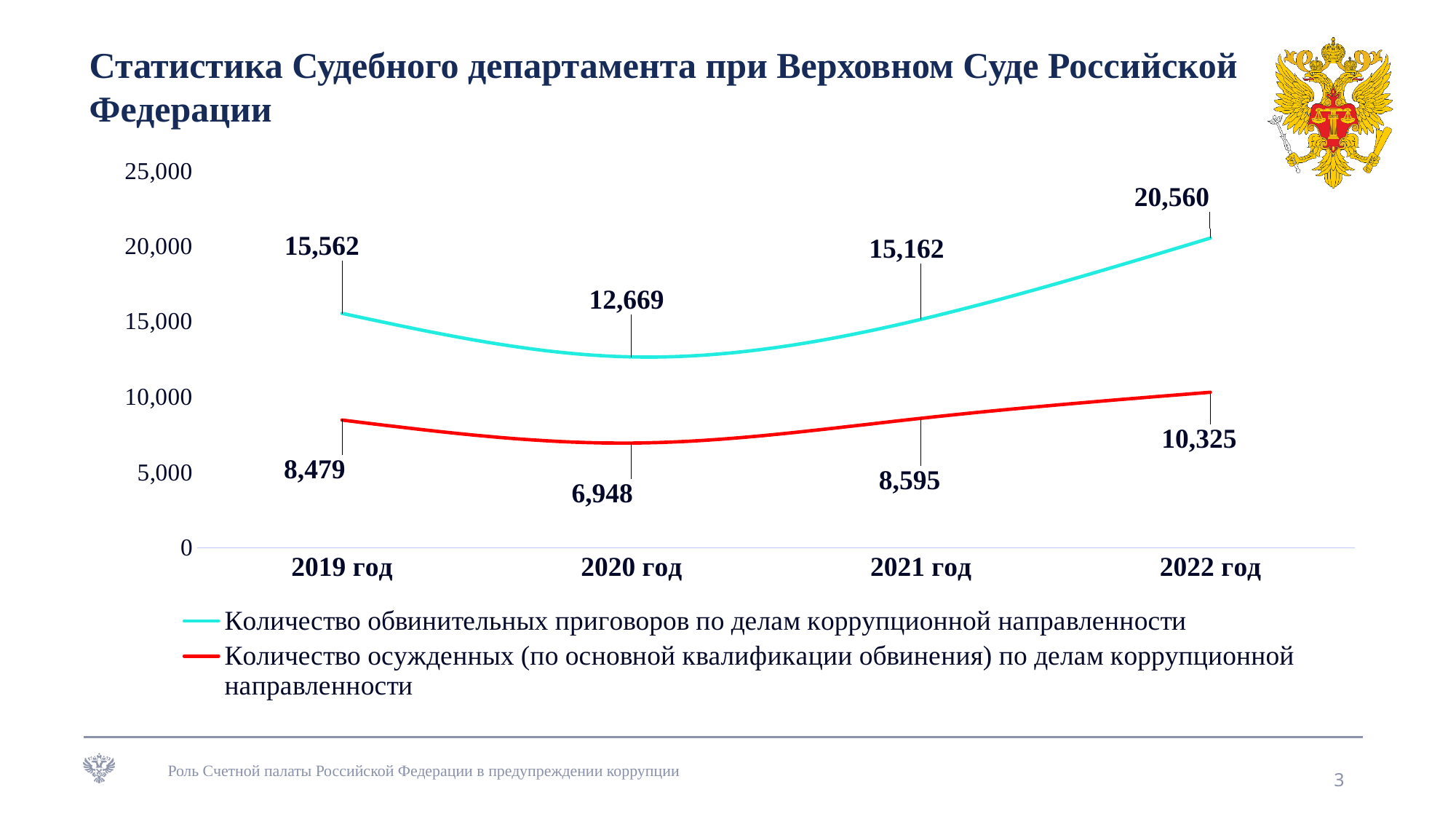
How many years are shown on the x axis? 4 What kind of chart is shown on the slide? Line chart What is the number of convicted persons (Количество осужденных) in 2020 год? 6,948 In which year is the number of convicted persons (Количество осужденных) highest? 2022 год What is the difference between the number of guilty verdicts and the number of convicted persons in 2019 год? 7,083 What colour is the line for Количество осужденных (по основной квалификации обвинения) по делам коррупционной направленности? Red What is the number of guilty verdicts in corruption cases (Количество обвинительных приговоров) in 2022 год? 20,560 What is the value of the cyan series (Количество обвинительных приговоров) for 2021 год? 15,162 In which year is the number of guilty verdicts (Количество обвинительных приговоров) lowest? 2020 год How many series does the legend list? 2 By how much did the number of guilty verdicts (Количество обвинительных приговоров) increase from 2021 год to 2022 год? 5,398 Which is larger: the number of convicted persons in 2019 год or in 2021 год? 2021 год